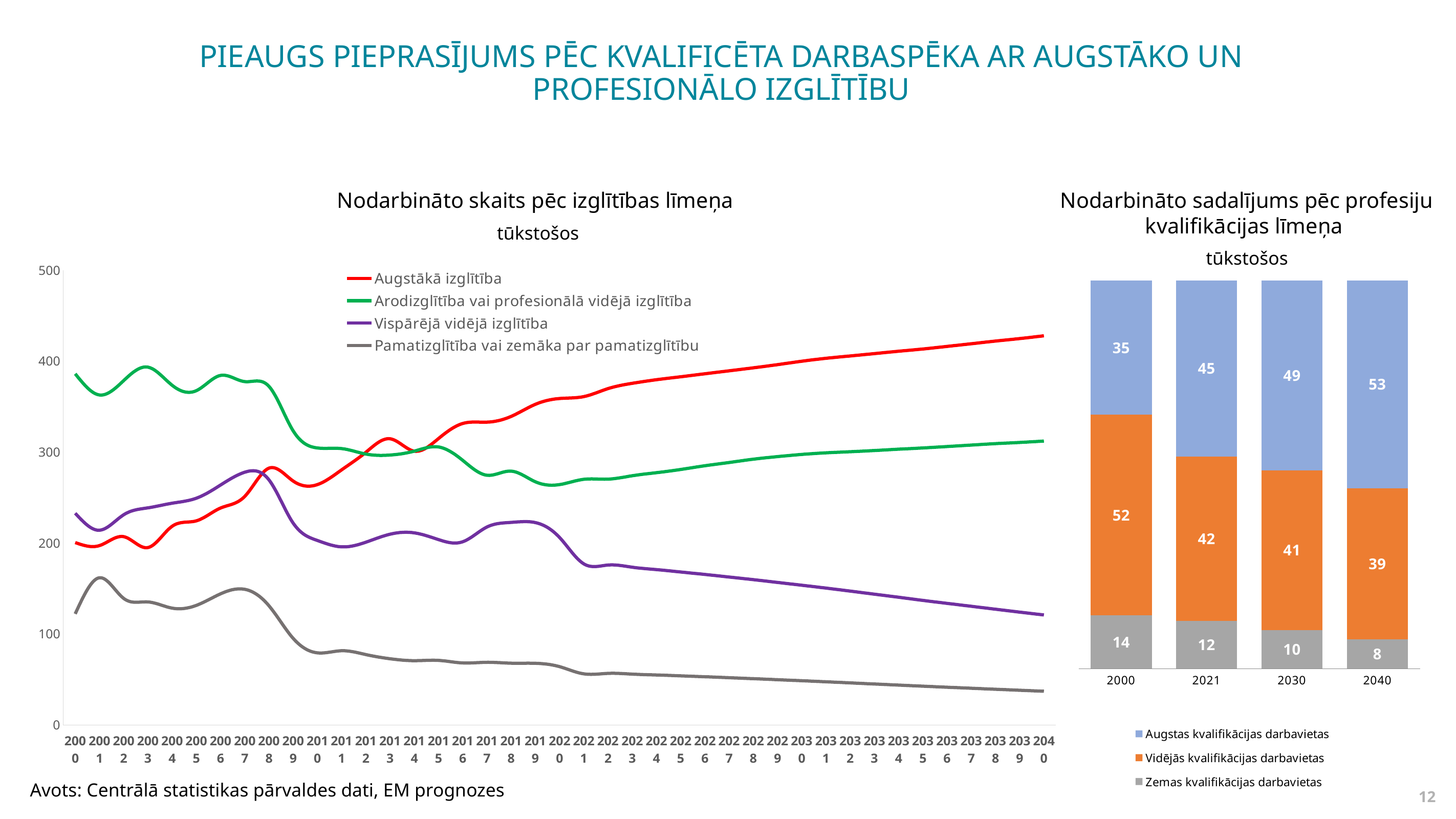
In the chart 'Nodarbināto sadalījums pēc profesiju kvalifikācijas līmeņa', what is the difference between Vidējās kvalifikācijas darbavietas in 2000 and in 2040? 13 What kind of chart is 'Nodarbināto skaits pēc izglītības līmeņa'? line chart In the chart 'Nodarbināto sadalījums pēc profesiju kvalifikācijas līmeņa', what is the total of the stacked bar for 2030? 100 In the chart 'Nodarbināto skaits pēc izglītības līmeņa', does the Pamatizglītība vai zemāka par pamatizglītību line rise or fall from 2000 to 2040? fall In the chart 'Nodarbināto sadalījums pēc profesiju kvalifikācijas līmeņa', what is the value for Vidējās kvalifikācijas darbavietas in 2021? 42 In the chart 'Nodarbināto sadalījums pēc profesiju kvalifikācijas līmeņa', what is the value for Augstas kvalifikācijas darbavietas in 2040? 53 In the chart 'Nodarbināto skaits pēc izglītības līmeņa', is the value for Augstākā izglītība in 2040 greater or less than 400? greater In the chart 'Nodarbināto sadalījums pēc profesiju kvalifikācijas līmeņa', what is the value for Zemas kvalifikācijas darbavietas in 2000? 14 In the chart 'Nodarbināto sadalījums pēc profesiju kvalifikācijas līmeņa', how many series does the legend list? 3 In the chart 'Nodarbināto sadalījums pēc profesiju kvalifikācijas līmeņa', which year has the highest value for Augstas kvalifikācijas darbavietas? 2040 In the chart 'Nodarbināto sadalījums pēc profesiju kvalifikācijas līmeņa', how many years are shown on the x axis? 4 In the chart 'Nodarbināto skaits pēc izglītības līmeņa', how many series does the legend list? 4